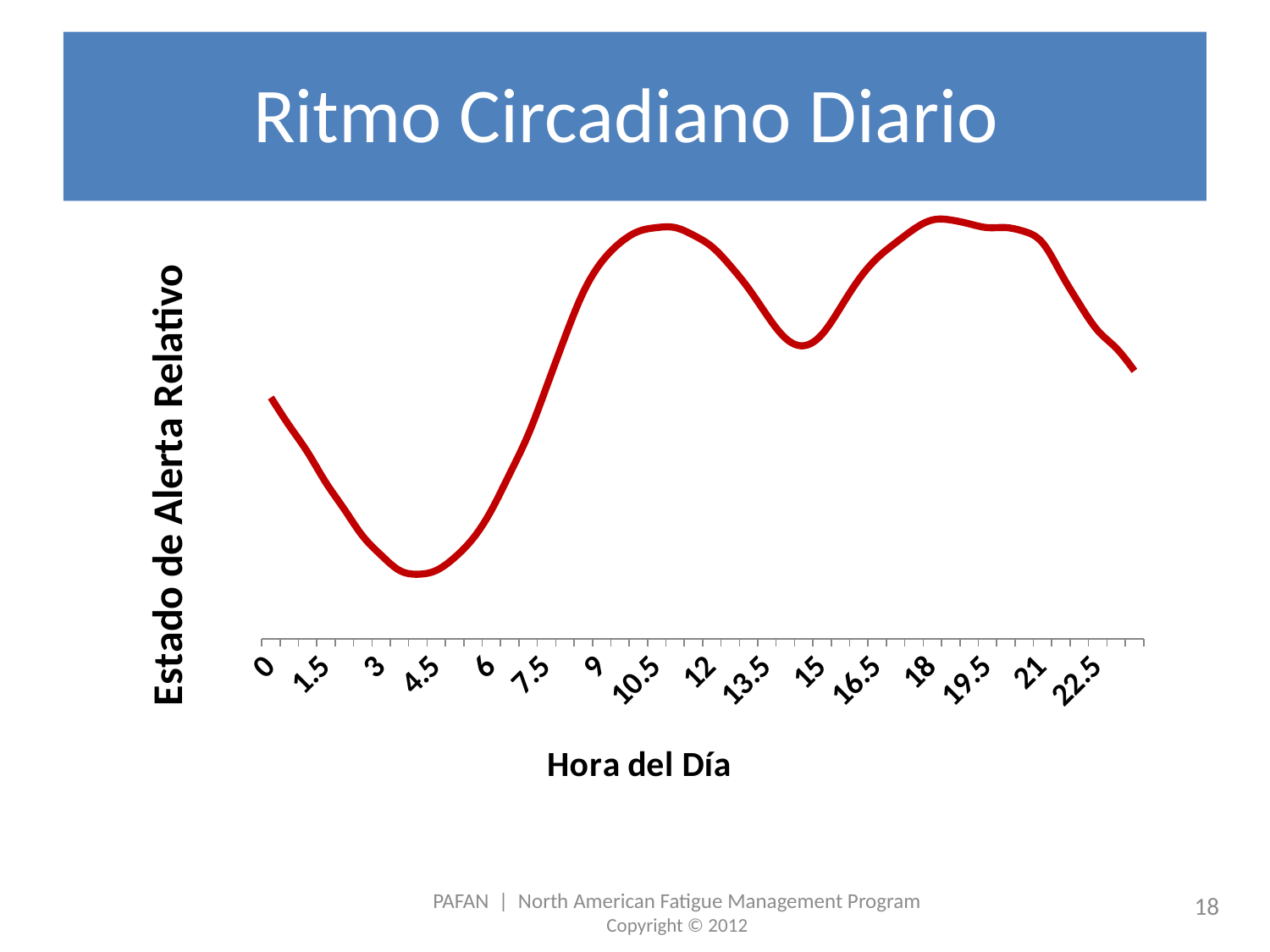
Does the line rise or fall between hour 10.5 and hour 15? fall What kind of chart is shown on the slide? line chart Which is higher, the value at hour 15 or the value at hour 4.5? hour 15 What is the title of the chart? Ritmo Circadiano Diario Does the line rise or fall between hour 4.5 and hour 10.5? rise Which is lower, the value at hour 0 or the value at hour 12? hour 0 Which is higher, the value at hour 9 or the value at hour 3? hour 9 Does the line rise or fall between hour 21 and hour 22.5? fall How many hour labels are shown on the x axis? 16 What is the label of the x axis? Hora del Día At which hour label on the x axis does the line reach its lowest point? 4.5